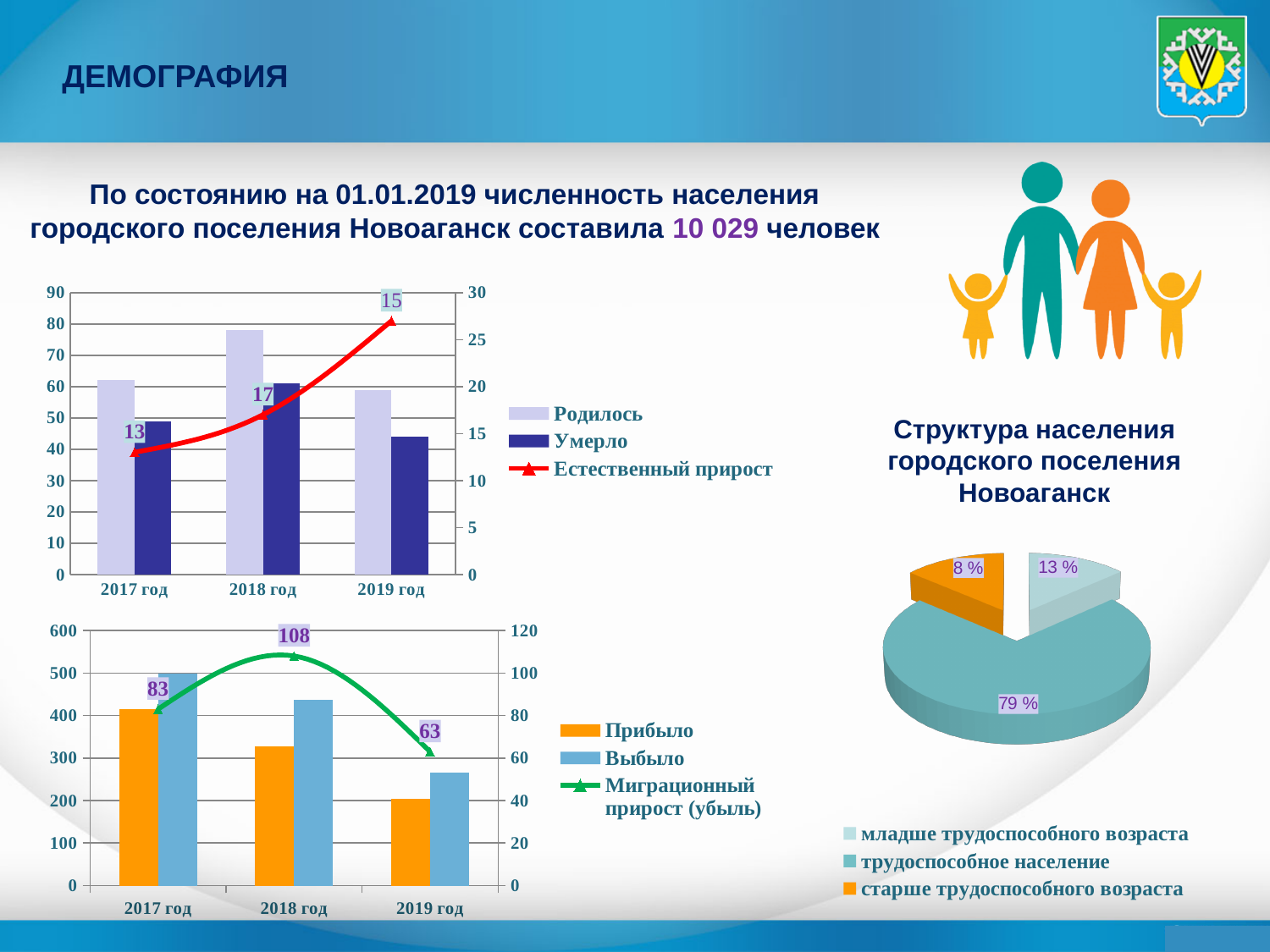
In the top-left chart, is the Родилось value for 2018 год greater or less than 70? greater In the top-left chart, what is the value of Естественный прирост for 2019 год? 15 In the top-left chart, how many series does the legend list? 3 In the bottom-left chart, what is the value of Миграционный прирост (убыль) for 2018 год? 108 In the bottom-left chart, what is the difference between Миграционный прирост (убыль) in 2018 год and 2019 год? 45 In the top-left chart, by how much does Естественный прирост in 2018 год exceed that in 2017 год? 4 In the pie chart Структура населения городского поселения Новоаганск, which category has the smallest share? старше трудоспособного возраста In the bottom-left chart, is the Прибыло value for 2018 год greater or less than 300? greater In the top-left chart, what is the value of Естественный прирост for 2018 год? 17 In the pie chart Структура населения городского поселения Новоаганск, what share is трудоспособное население? 79 % In the bottom-left chart, which year has the lowest Миграционный прирост (убыль)? 2019 год